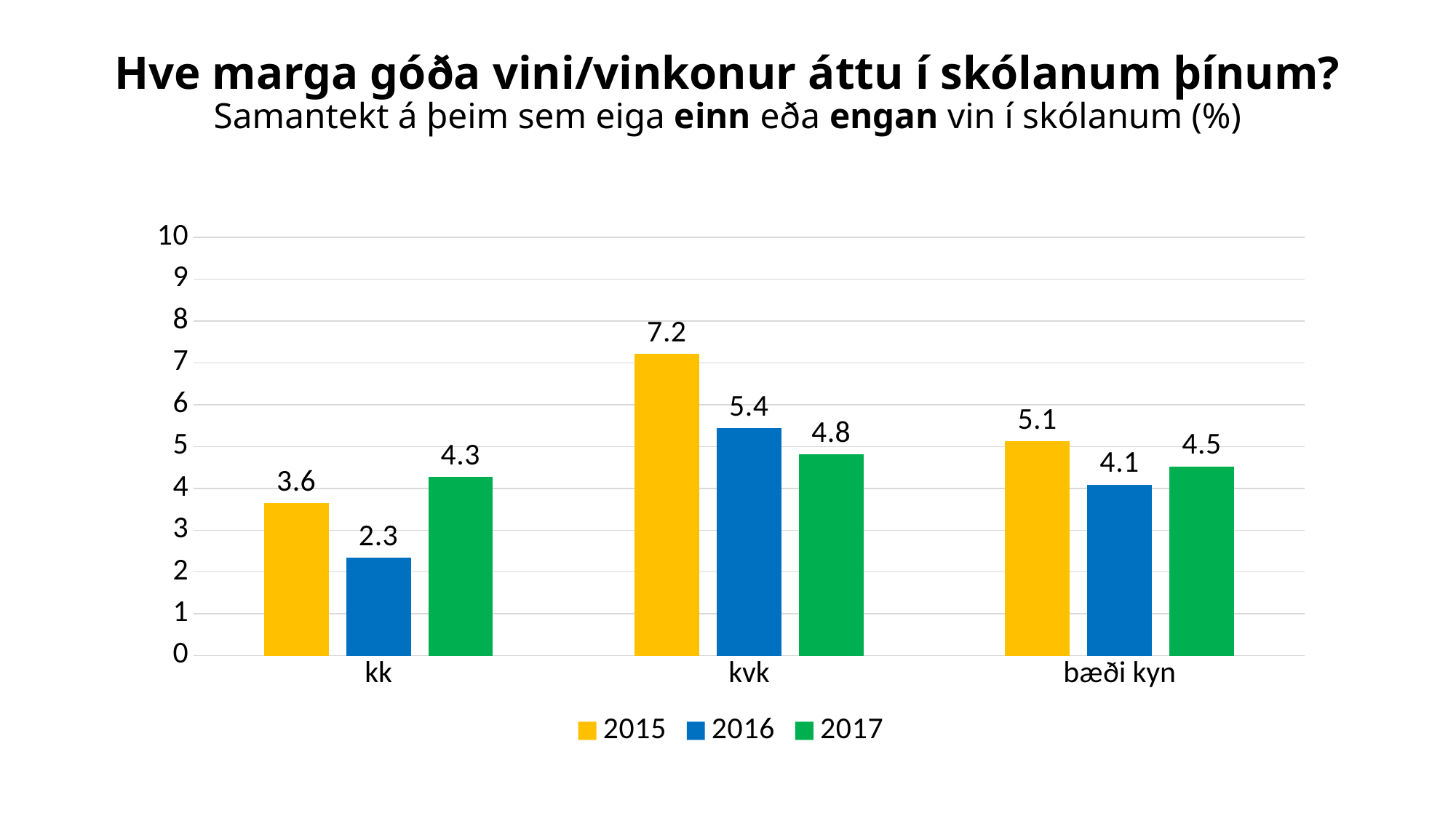
Which category has the highest value in the 2015 series? kvk What is the value for bæði kyn in 2017? 4.5 What is the value for kvk in 2015? 7.2 How many categories are shown on the x axis? 3 Is the value for kvk in 2015 greater or less than 7? greater What is the value for kk in 2016? 2.3 What kind of chart is shown on the slide? bar chart Which is larger for kk: the 2015 value or the 2017 value? 2017 What is the difference between the 2015 and 2016 values for kvk? 1.8 How many series does the legend list? 3 Which category has the lowest value in the 2016 series? kk Which colour represents the 2017 series in the legend? green